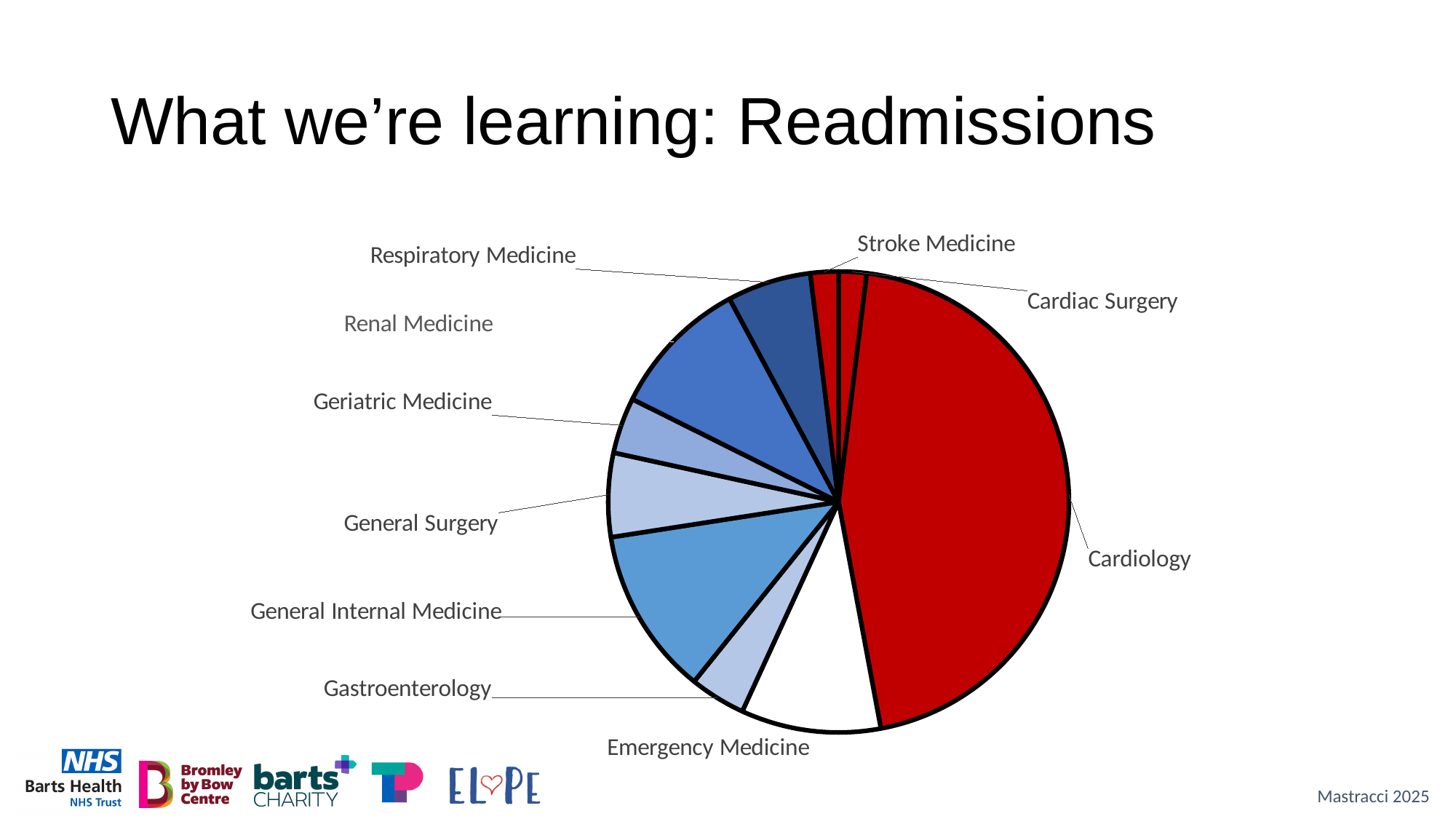
What colour is the Cardiology slice of the pie? Red Which slice is larger, General Internal Medicine or Gastroenterology? General Internal Medicine Which slice is larger, Cardiology or Cardiac Surgery? Cardiology Which slice is larger, Cardiology or Emergency Medicine? Cardiology What is the title of the slide containing the pie chart? What we're learning: Readmissions Which category has the largest slice of the pie? Cardiology What kind of chart is shown on the slide? Pie chart